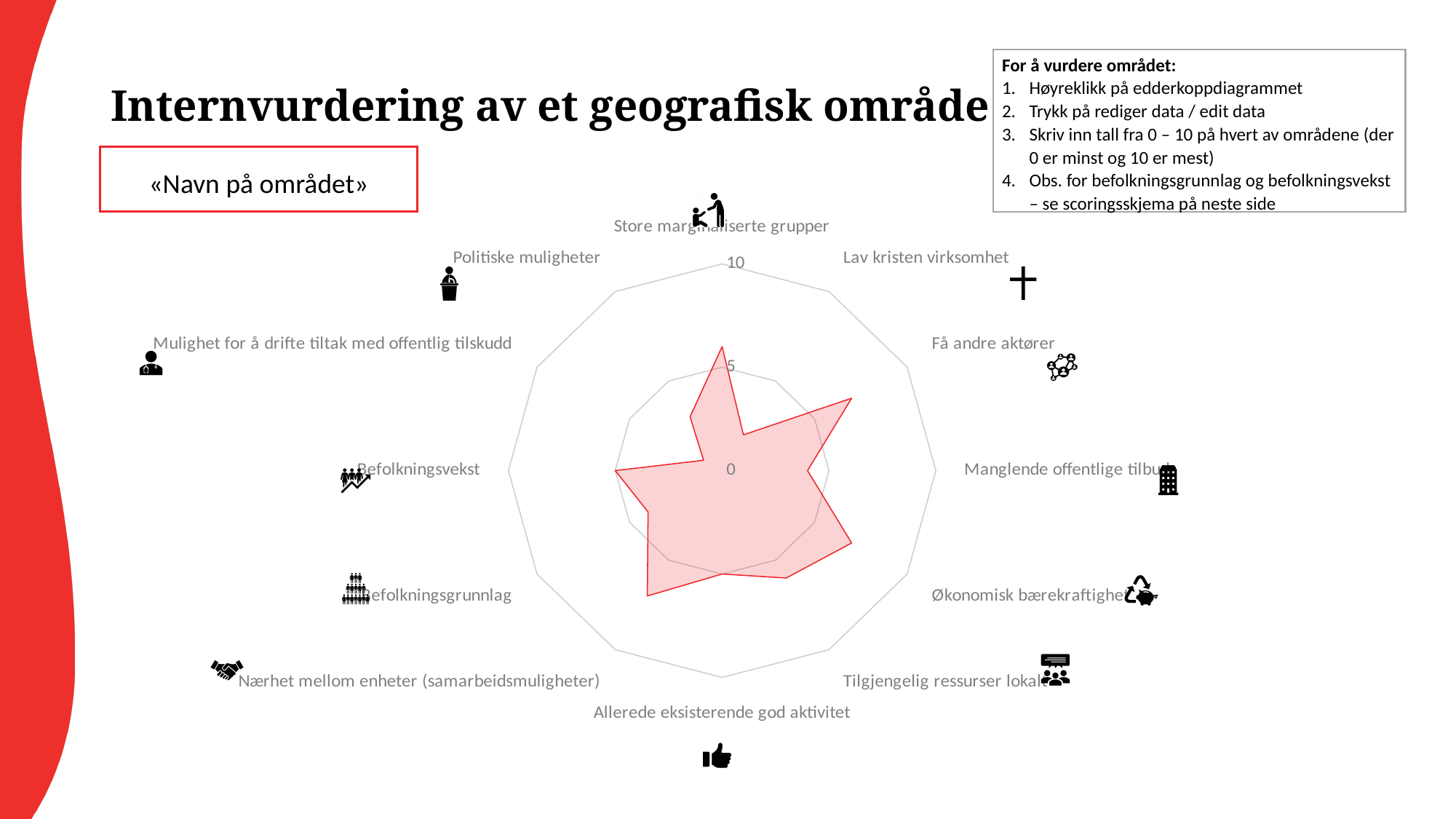
What is the maximum value shown on the radar chart's axis? 10 Is the value for Lav kristen virksomhet greater or less than 5? less Is the value for Politiske muligheter greater or less than 5? less What kind of chart is shown on the slide? Radar chart Is the value for Få andre aktører greater or less than 5? greater Which has the larger value, Store marginaliserte grupper or Mulighet for å drifte tiltak med offentlig tilskudd? Store marginaliserte grupper Which has the larger value, Få andre aktører or Lav kristen virksomhet? Få andre aktører How many categories does the radar chart have? 12